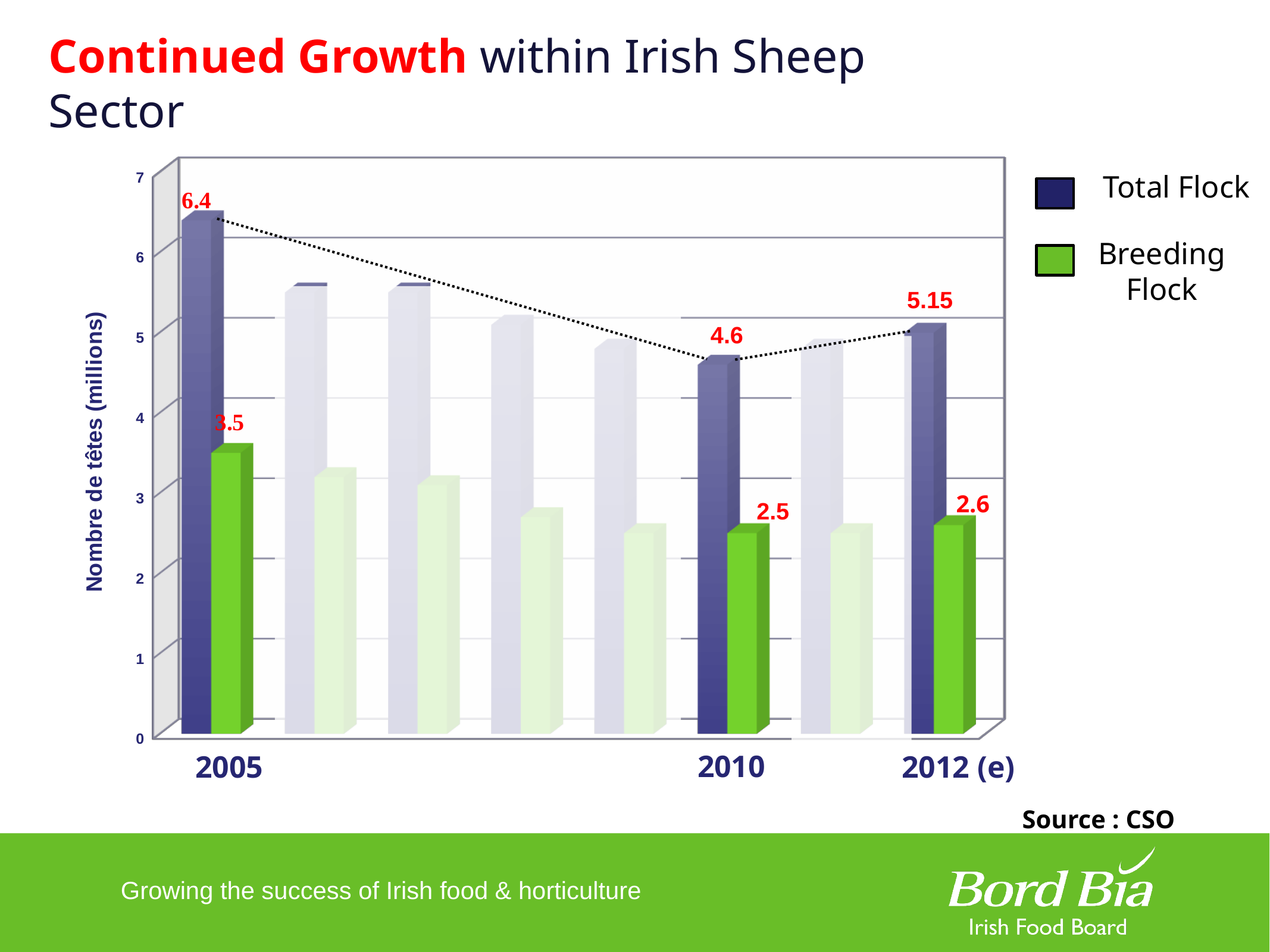
What is the difference between the Total Flock values for 2005 and 2010? 1.8 How many series does the legend list? 2 What kind of chart is shown on the slide? bar chart Which labelled year has the highest Total Flock value? 2005 What is the y-axis title of the chart? Nombre de têtes (millions) Which labelled year has the lowest Breeding Flock value? 2010 What is the Breeding Flock value for 2010? 2.5 Which is larger, the Total Flock value for 2010 or for 2012 (e)? 2012 (e) Is the Breeding Flock value for 2005 greater or less than 3? greater What is the Breeding Flock value for 2012 (e)? 2.6 What is the Total Flock value for 2005? 6.4 What is the Total Flock value for 2012 (e)? 5.15